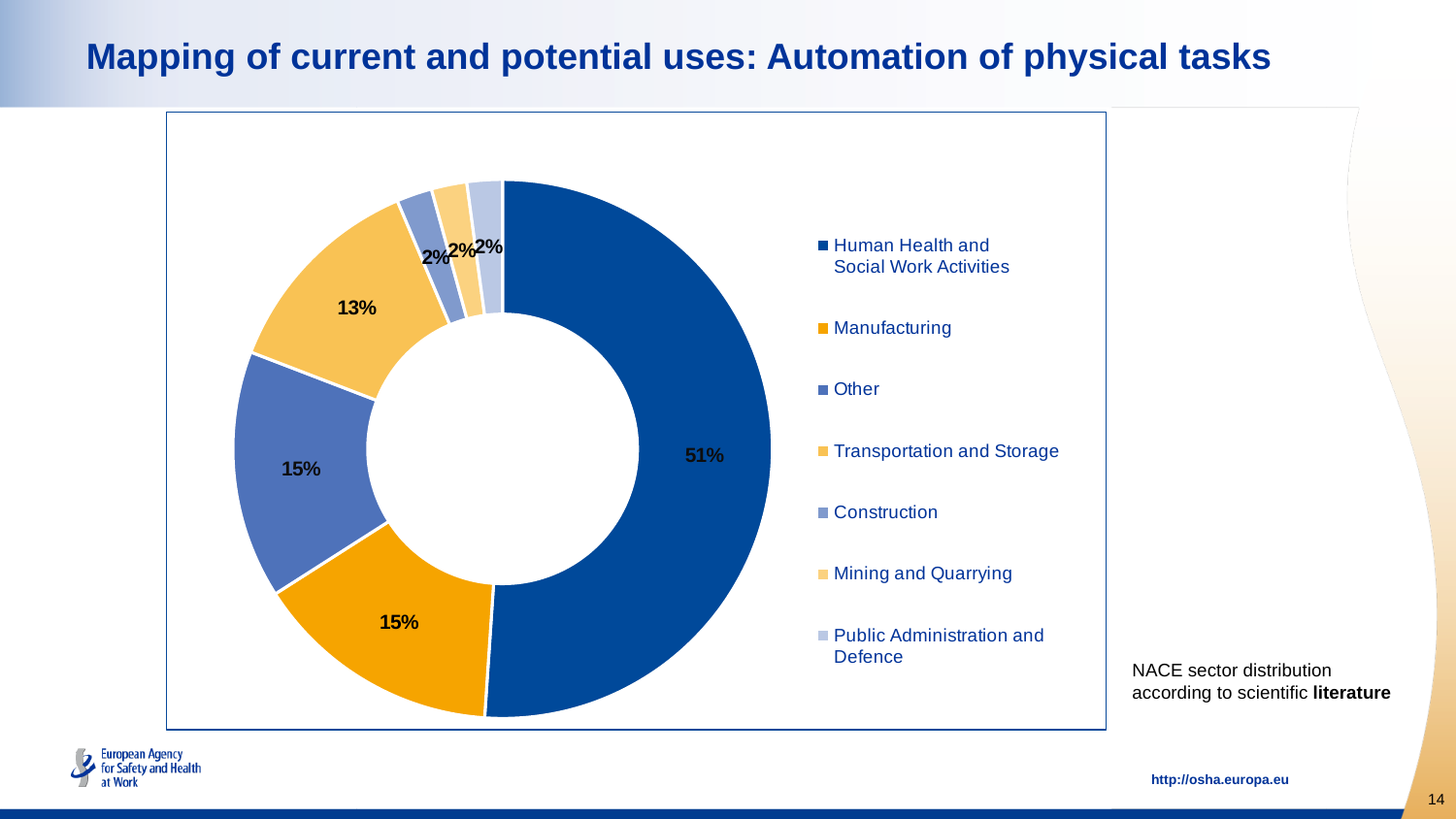
What is the difference in percentage points between Human Health and Social Work Activities and Manufacturing? 36 percentage points What is the value shown for Transportation and Storage? 13% What kind of chart is shown on the slide? doughnut chart What is the value shown for Manufacturing? 15% Which is larger, the share for Transportation and Storage or the share for Other? Other What is the value shown for Mining and Quarrying? 2% What share of the chart does Human Health and Social Work Activities account for? 51% What is the smallest percentage shown on the chart? 2% Which sector has the largest share in the chart? Human Health and Social Work Activities Which legend entry is listed last in the chart's legend? Public Administration and Defence What is the value shown for Construction? 2% How many sectors (slices) does the chart show? 7